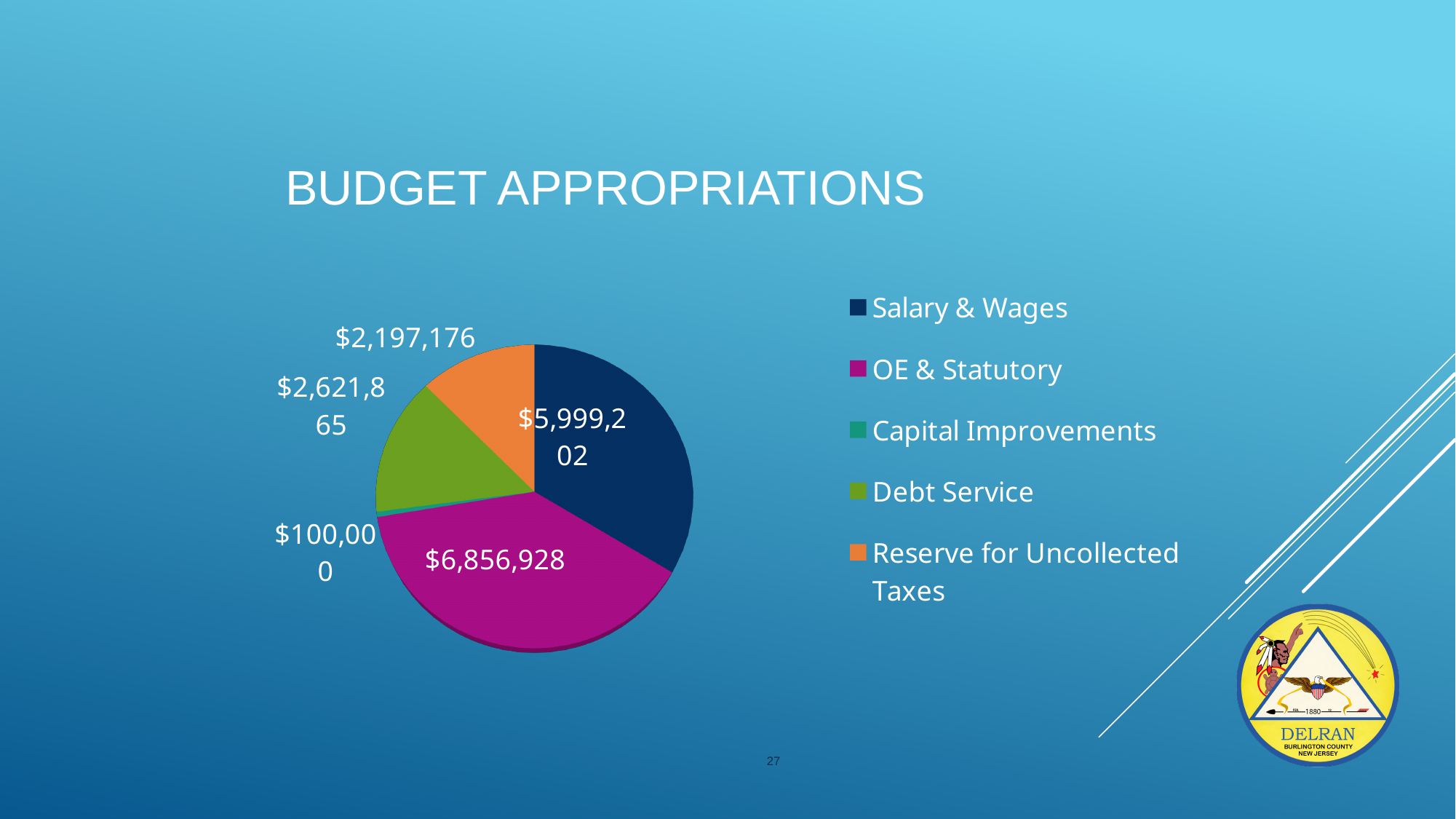
What is the difference between OE & Statutory and Salary & Wages? $857,726 Which category has the smallest value? Capital Improvements What is the value for Capital Improvements? $100,000 Which colour represents Debt Service in the legend? Green Which category has the largest value? OE & Statutory What type of chart is shown on the slide? Pie chart What is the title of the chart? Budget Appropriations What is the value for Reserve for Uncollected Taxes? $2,197,176 How many categories does the pie chart have? 5 What is the value for OE & Statutory? $6,856,928 What is the value for Salary & Wages? $5,999,202 Which is larger, Debt Service or Reserve for Uncollected Taxes? Debt Service